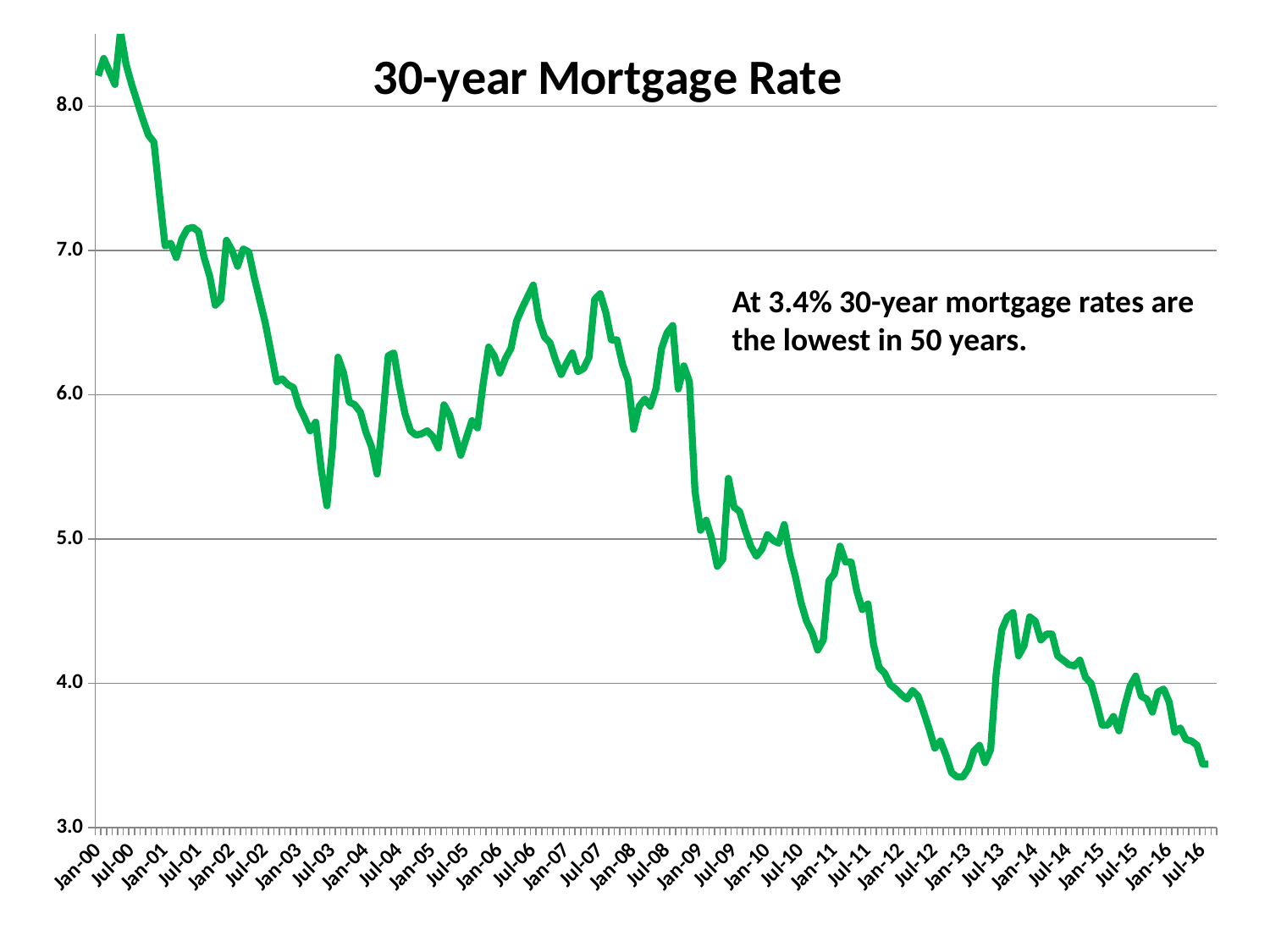
Which is larger, the value at Jan-00 or the value at Jul-16? Jan-00 Overall, does the mortgage rate rise or fall from Jan-00 to Jul-16? fall Is the value at Jul-16 greater or less than 4.0? less What is the title of the chart? 30-year Mortgage Rate Is the value at Jan-00 greater or less than 8.0? greater Which is larger, the value at Jul-06 or the value at Jul-09? Jul-06 Is the value at Jul-06 greater or less than 6.0? greater What kind of chart is shown on the slide? line chart According to the text on the slide, what rate is described as the lowest in 50 years? 3.4%